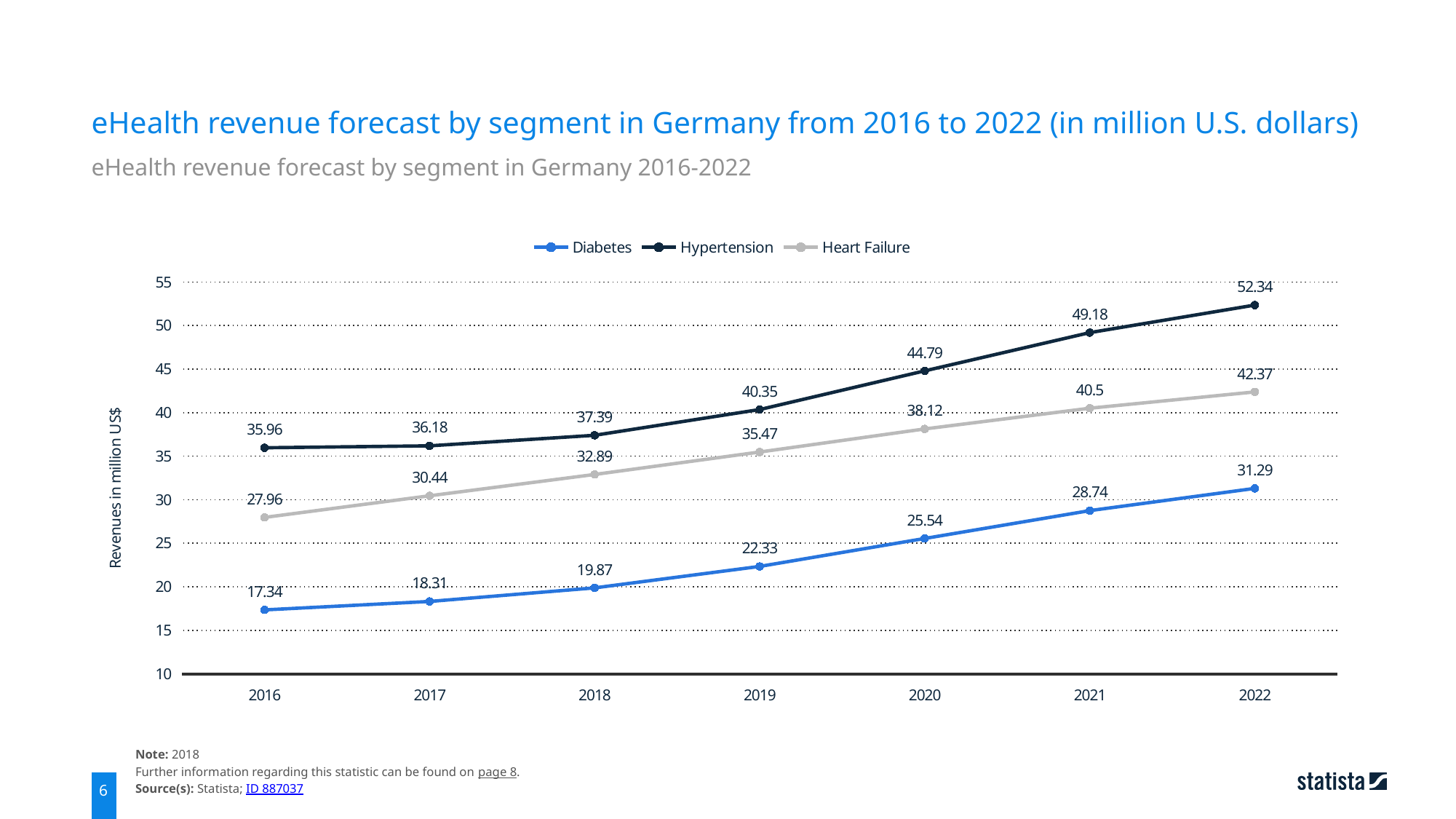
What is the Heart Failure revenue forecast for 2019? 35.47 Which segment has the larger forecast in 2021, Heart Failure or Diabetes? Heart Failure What is the difference between the Hypertension and Diabetes forecasts in 2020? 19.25 How many series does the legend list? 3 Does the Heart Failure series rise or fall from 2016 to 2022? rise What is the Hypertension revenue forecast for 2022? 52.34 In which year is the Diabetes revenue forecast highest? 2022 Is the Hypertension value for 2019 greater or less than 45? less How many years are shown on the x axis? 7 What kind of chart is shown on the slide? line chart In which year is the Heart Failure revenue forecast lowest? 2016 What is the Diabetes revenue forecast for 2016? 17.34